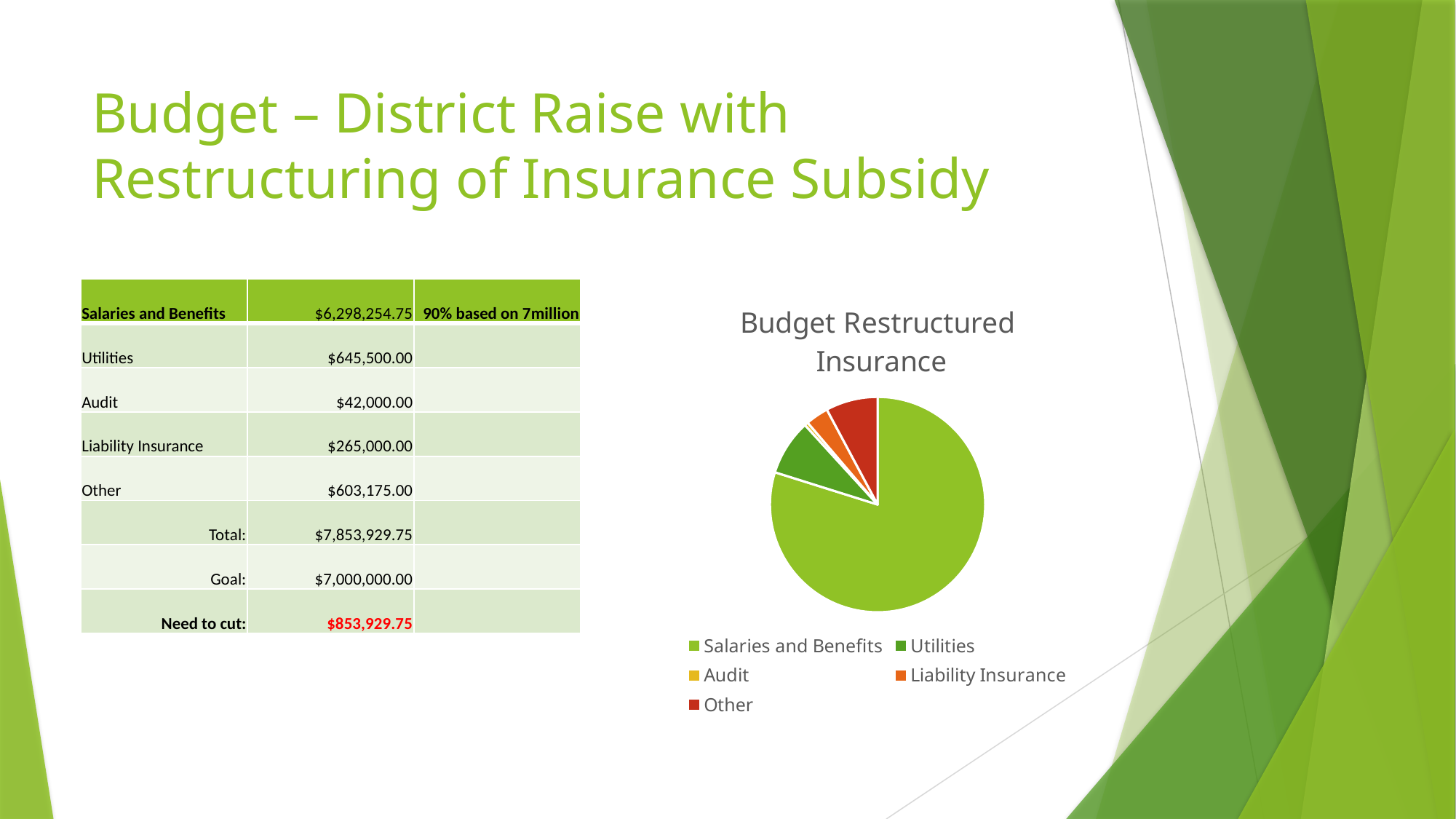
What kind of chart is shown on the slide? pie chart Which category has the smallest slice in the pie chart? Audit In the pie chart, which slice is larger: Other or Audit? Other In the pie chart, which slice is larger: Liability Insurance or Audit? Liability Insurance How many entries does the pie chart's legend list? 5 How many slices does the pie chart have? 5 In the pie chart, which slice is larger: Utilities or Liability Insurance? Utilities Which category has the largest slice in the pie chart? Salaries and Benefits What is the title of the pie chart? Budget Restructured Insurance